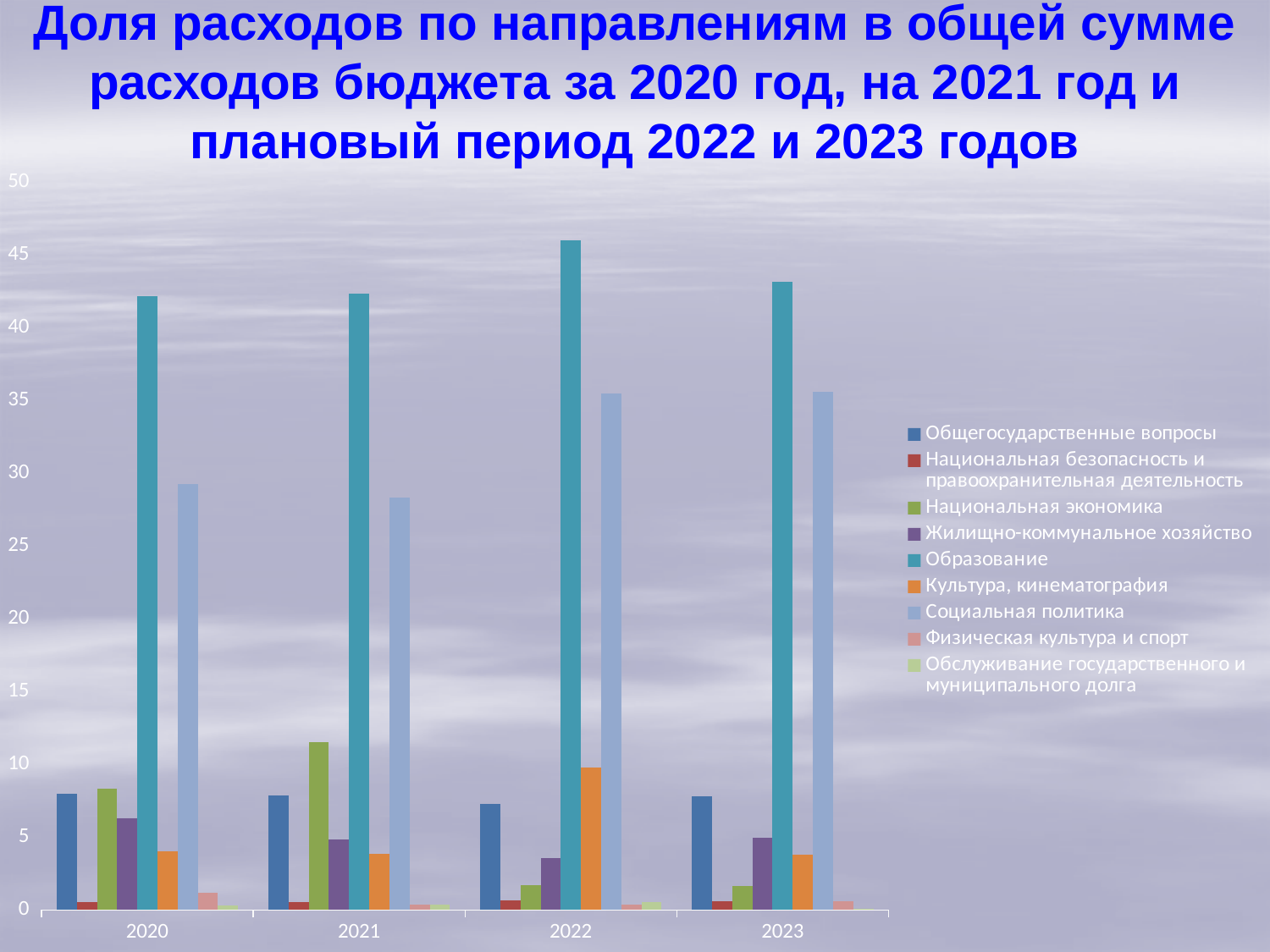
What kind of chart is shown on the slide? bar chart Is the value for Национальная экономика in 2021 greater or less than 10? greater Is the value for Социальная политика in 2020 greater or less than 25? greater Which series is shown in orange in the legend? Культура, кинематография Which is larger: Национальная экономика in 2020 or in 2021? 2021 How many years (categories) are shown on the x axis? 4 Is the value for Культура, кинематография in 2022 greater or less than 5? greater Which is larger: Социальная политика in 2020 or in 2022? 2022 Which series has the highest bar in 2020? Образование In which year is the bar for Образование the highest? 2022 How many series does the legend list? 9